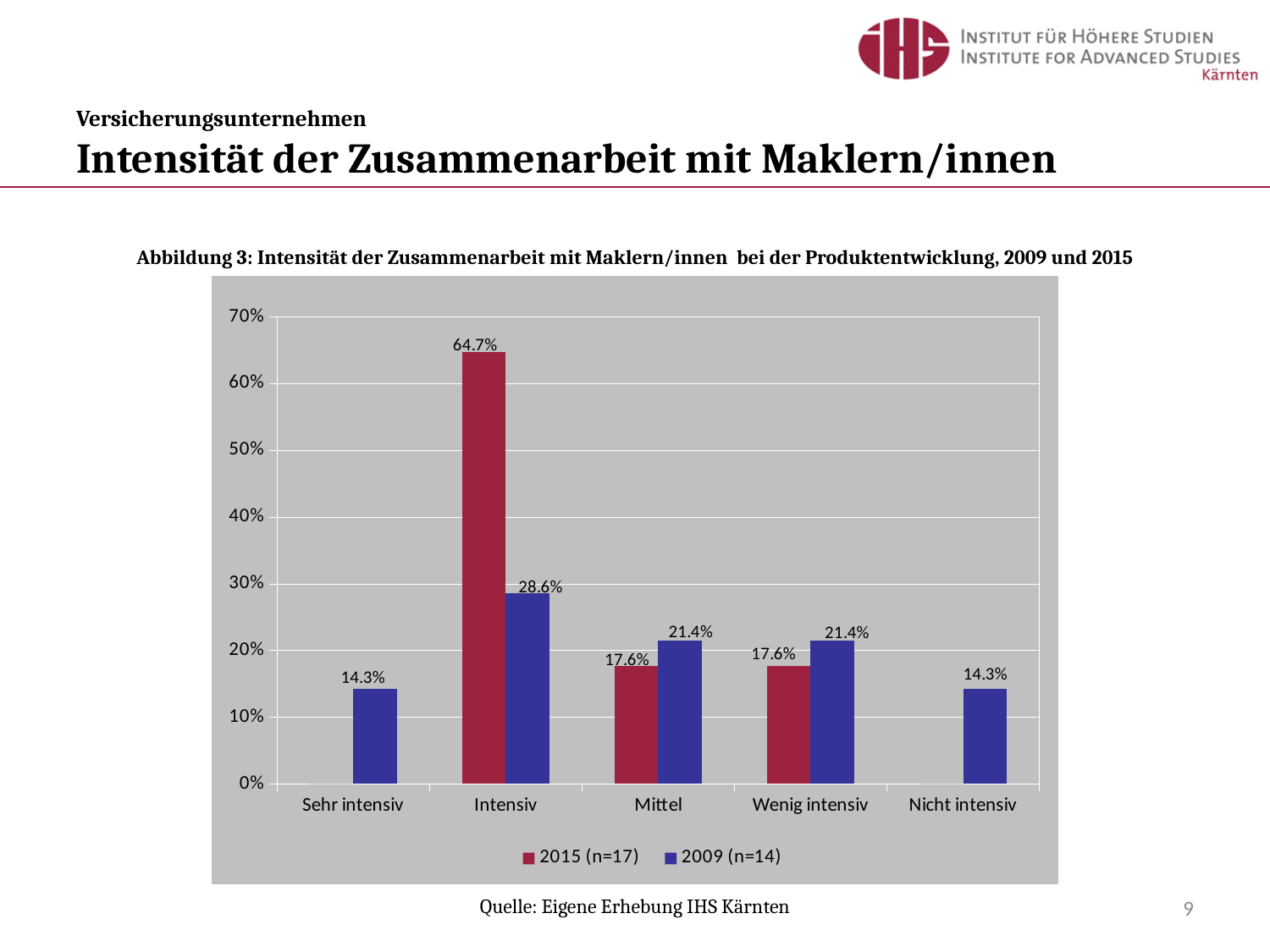
In the Wenig intensiv category, which series has the larger value, 2015 (n=17) or 2009 (n=14)? 2009 (n=14) Which category has the highest value for 2015 (n=17)? Intensiv What is the value for 2015 (n=17) in the Mittel category? 17.6% What kind of chart is shown on the slide? Bar chart Which category has the highest value for 2009 (n=14)? Intensiv What is the value for 2009 (n=14) in the Intensiv category? 28.6% What is the value for 2009 (n=14) in the Nicht intensiv category? 14.3% What is the value for 2015 (n=17) in the Intensiv category? 64.7% What is the difference between the 2015 (n=17) and 2009 (n=14) values in the Intensiv category? 36.1% How many categories are shown on the x axis? 5 What is the value for 2009 (n=14) in the Sehr intensiv category? 14.3% How many series does the legend list? 2